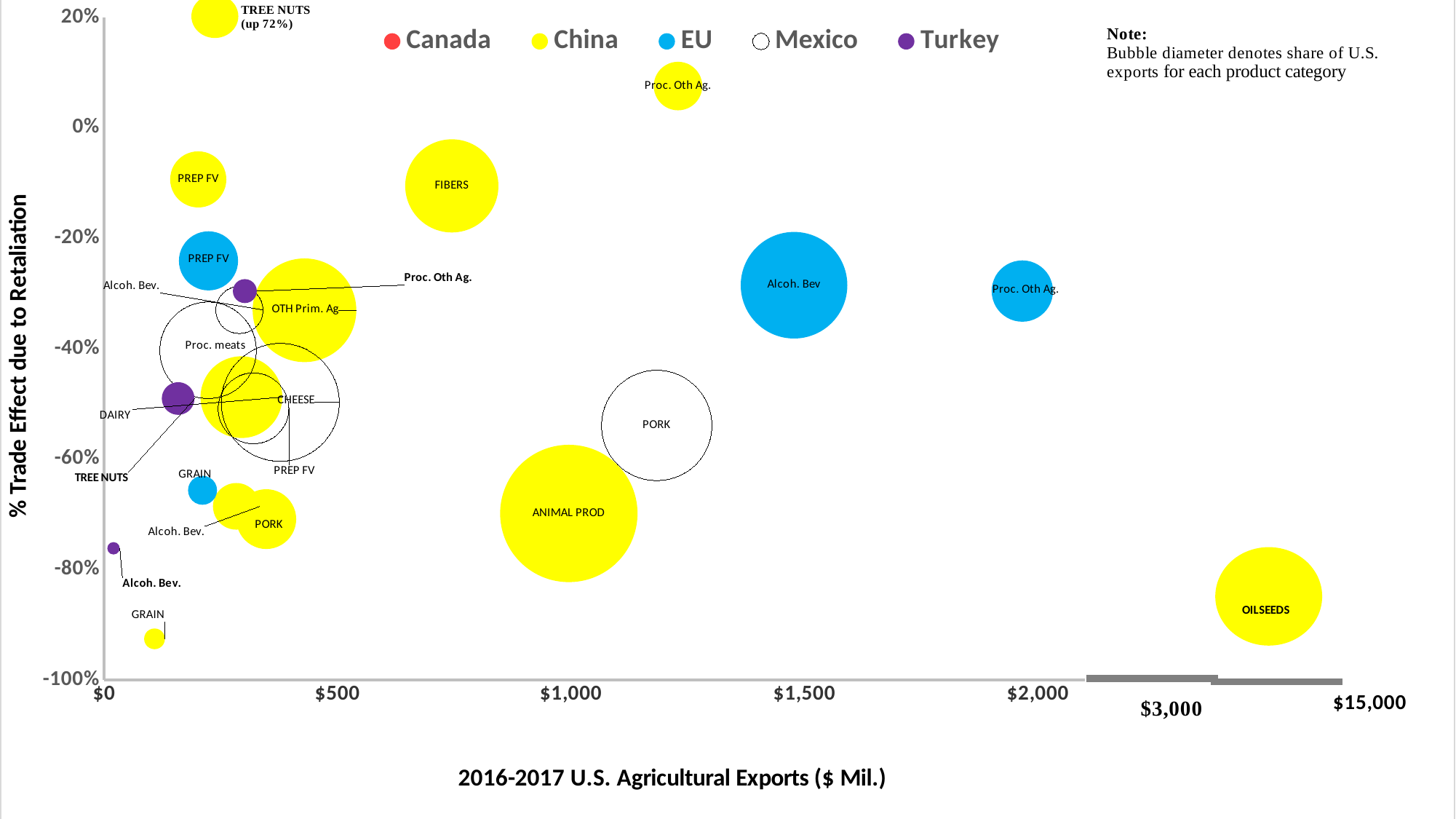
Which has the higher trade effect, China FIBERS or China ANIMAL PROD? China FIBERS Is the trade effect for China ANIMAL PROD greater or less than -60%? less What is the title of the x axis? 2016-2017 U.S. Agricultural Exports ($ Mil.) Is the trade effect for Mexico PORK greater or less than -40%? less Is the trade effect for the EU Alcoh. Bev bubble greater or less than -40%? greater Which product bubble has the highest trade effect on the chart? China TREE NUTS What kind of chart is shown on the slide? bubble chart What percentage change is noted for China TREE NUTS? up 72% How many series does the legend list? 5 According to the note, what does the bubble diameter denote? share of U.S. exports for each product category